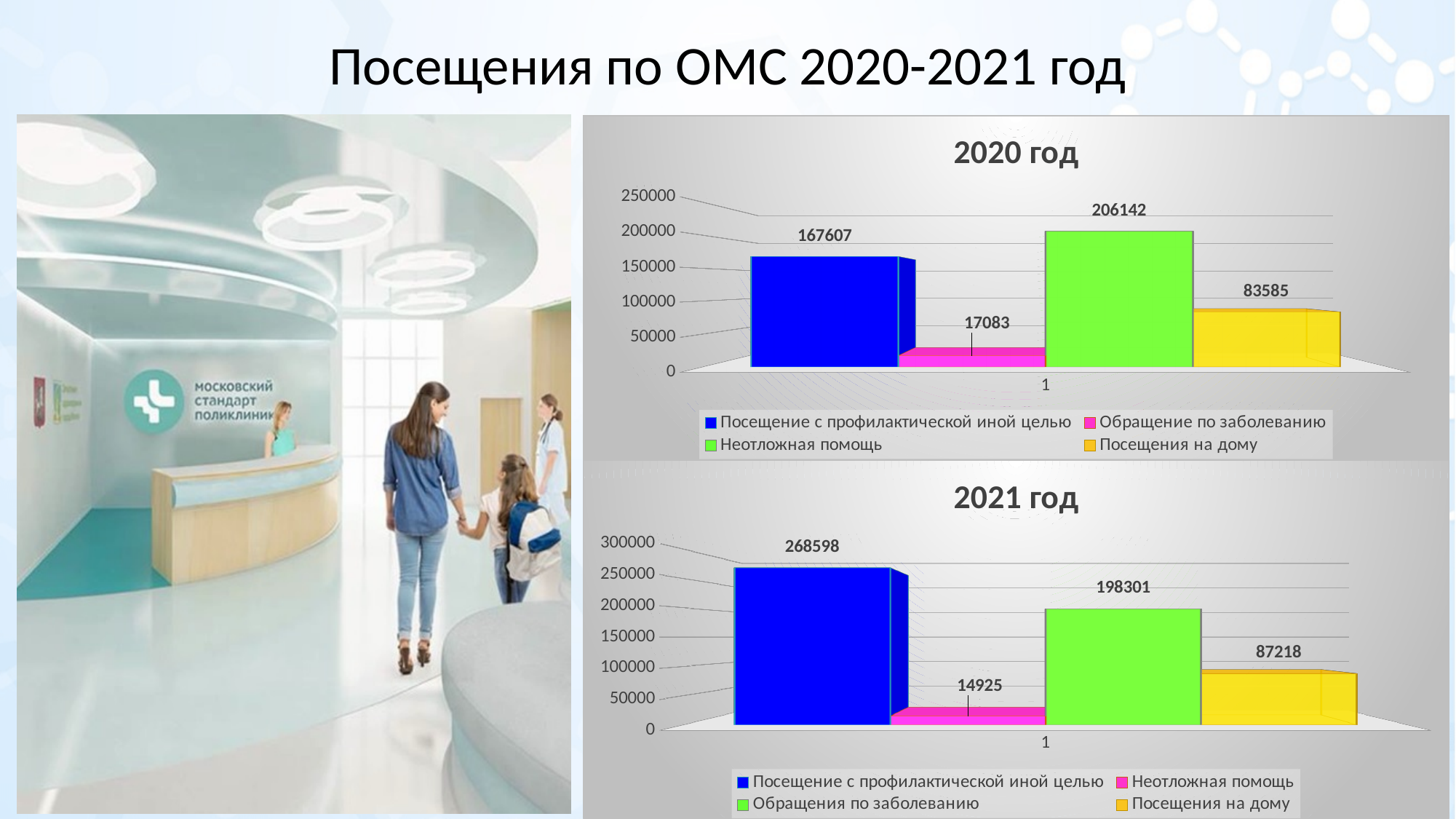
In the "2021 год" chart, what is the value for "Неотложная помощь"? 14925 In the "2020 год" chart, what is the difference between "Неотложная помощь" and "Посещения на дому"? 122557 In the "2020 год" chart, which series has the highest value? Неотложная помощь In the "2021 год" chart, what colour is the bar for "Посещения на дому"? Yellow In the "2020 год" chart, which is larger: "Посещение с профилактической иной целью" or "Неотложная помощь"? Неотложная помощь In the "2021 год" chart, what is the difference between "Посещение с профилактической иной целью" and "Обращения по заболеванию"? 70297 In the "2020 год" chart, what is the value for "Посещение с профилактической иной целью"? 167607 In the "2021 год" chart, what is the value for "Обращения по заболеванию"? 198301 In the "2020 год" chart, what is the value for "Посещения на дому"? 83585 How many series does the legend of the "2021 год" chart list? 4 What kind of chart is the "2020 год" chart? Bar chart In the "2021 год" chart, which series has the lowest value? Неотложная помощь